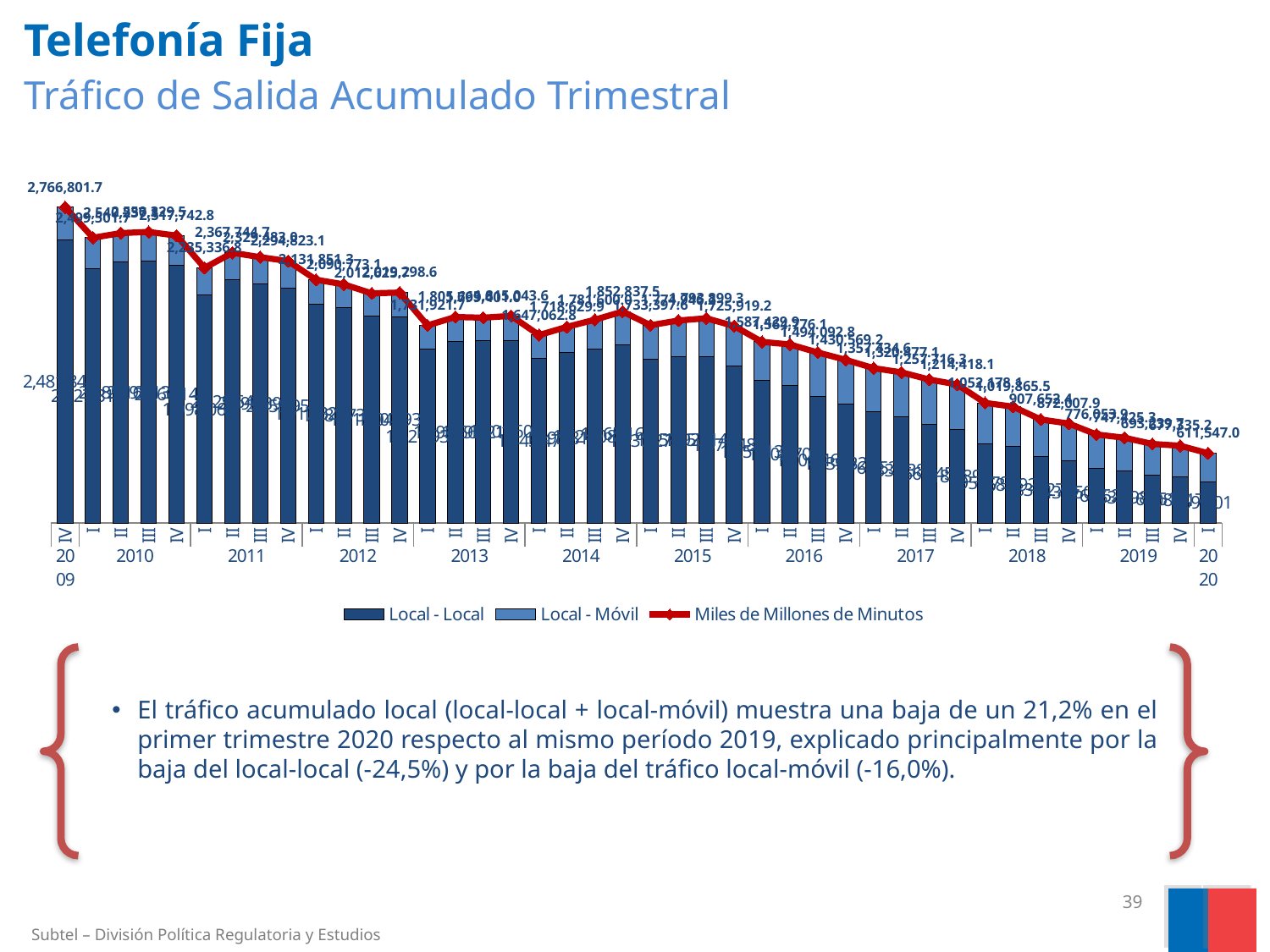
What is the subtitle of the chart on the slide? Tráfico de Salida Acumulado Trimestral Which quarter has the lowest value on the Miles de Millones de Minutos line? I 2020 How many series does the legend list? 3 Which is larger, the line value for IV 2009 or for I 2020? IV 2009 Which quarter has the highest value on the Miles de Millones de Minutos line? IV 2009 What is the value of the Miles de Millones de Minutos line for IV 2009? 2,766,801.7 Do the values of the Miles de Millones de Minutos line rise or fall from IV 2009 to I 2020? Fall What is the value of the Miles de Millones de Minutos line for I 2020? 611,547.0 What is the difference between the line value for IV 2009 (2,766,801.7) and for I 2020 (611,547.0)? 2,155,254.7 What kind of chart is shown on the slide? A stacked bar chart with a line overlay What are the three series listed in the legend? Local - Local, Local - Móvil, Miles de Millones de Minutos How many quarters are plotted on the x axis? 42